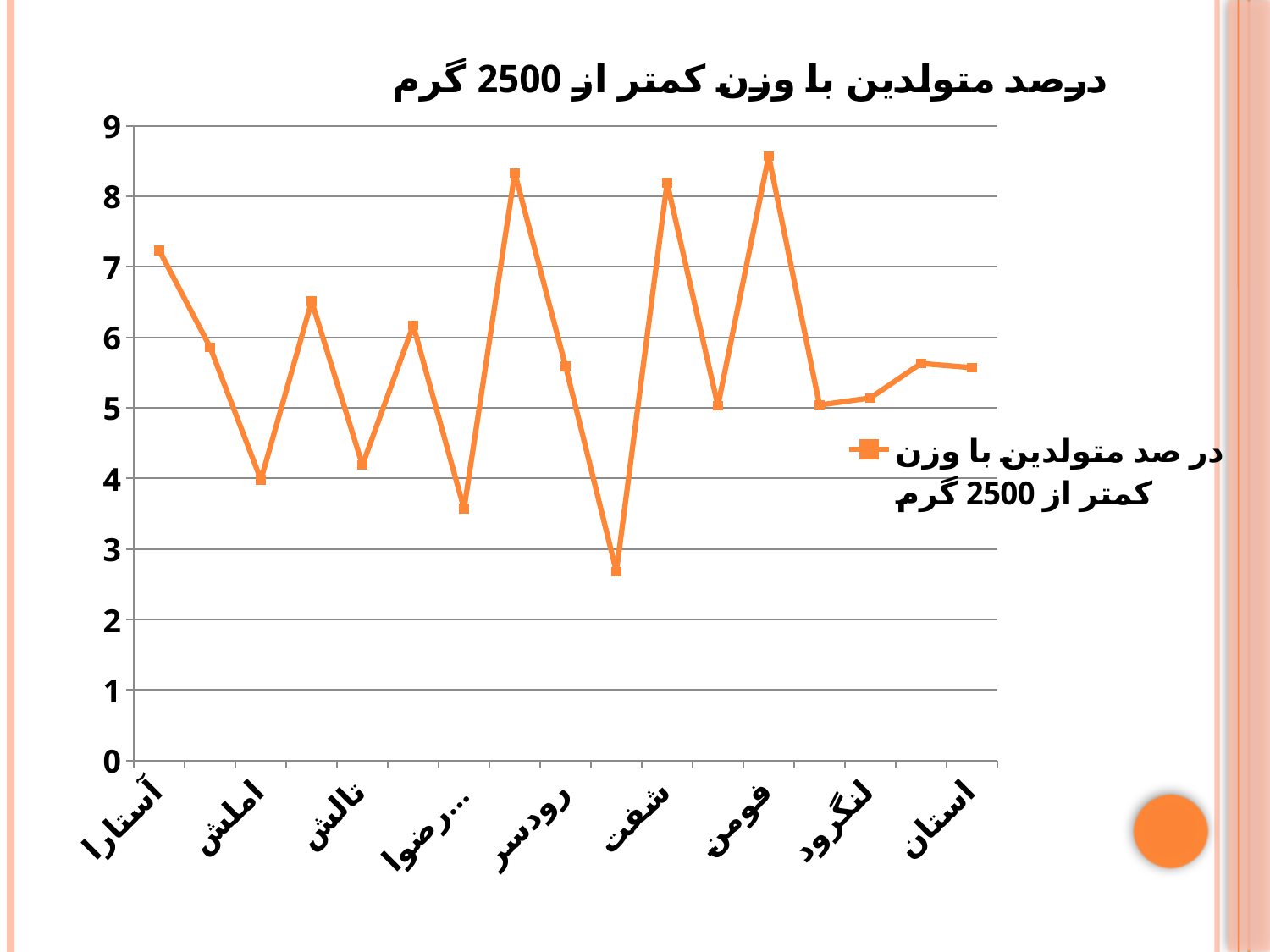
What kind of chart is shown on the slide? line chart Which of the labelled categories has the highest value? فومن Is the value for آستارا greater or less than 6? greater Is the value for فومن greater or less than 8? greater Is the value for تالش greater or less than 5? less Which has the larger value, آستارا or املش? آستارا How many data points are plotted on the line? 17 How many series does the legend list? 1 What is the title of the chart? درصد متولدین با وزن کمتر از 2500 گرم